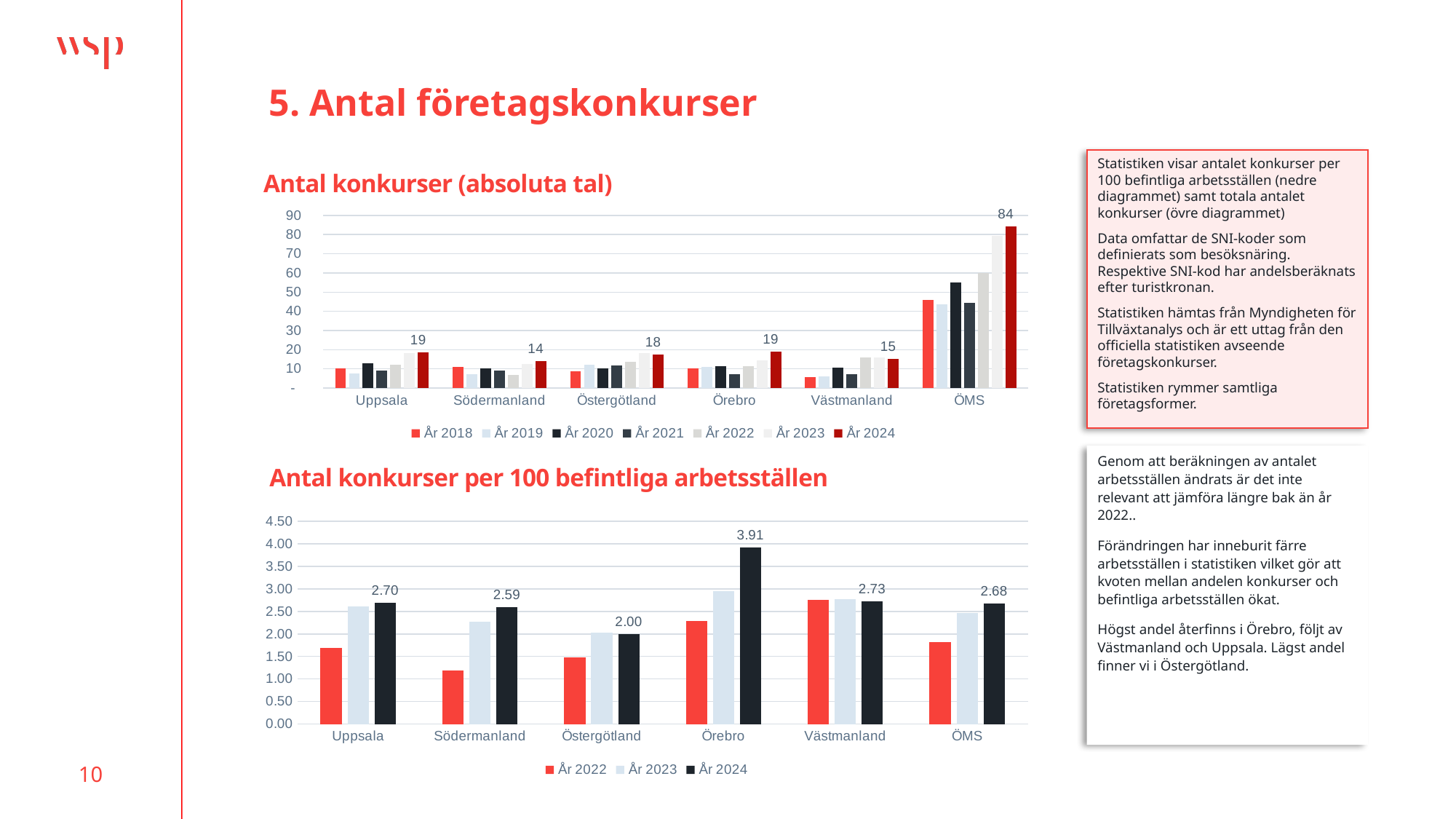
In the chart 'Antal konkurser (absoluta tal)', what is the difference between the År 2024 values for ÖMS and Uppsala? 65 In the chart 'Antal konkurser per 100 befintliga arbetsställen', what is the difference between the År 2024 values for Örebro and Östergötland? 1.91 In the chart 'Antal konkurser (absoluta tal)', is the År 2023 value for ÖMS greater or less than 70? greater In the chart 'Antal konkurser per 100 befintliga arbetsställen', which category has the lowest År 2024 value? Östergötland In the chart 'Antal konkurser per 100 befintliga arbetsställen', how many categories are shown on the x axis? 6 In the chart 'Antal konkurser (absoluta tal)', what is the value for ÖMS in År 2024? 84 In the chart 'Antal konkurser (absoluta tal)', what is the value for Södermanland in År 2024? 14 What kind of chart is 'Antal konkurser per 100 befintliga arbetsställen'? Bar chart In the chart 'Antal konkurser (absoluta tal)', how many series does the legend list? 7 In the chart 'Antal konkurser per 100 befintliga arbetsställen', which category has the highest År 2024 value? Örebro In the chart 'Antal konkurser per 100 befintliga arbetsställen', is the År 2022 value for Södermanland greater or less than 1.50? less In the chart 'Antal konkurser per 100 befintliga arbetsställen', what is the value for Örebro in År 2024? 3.91